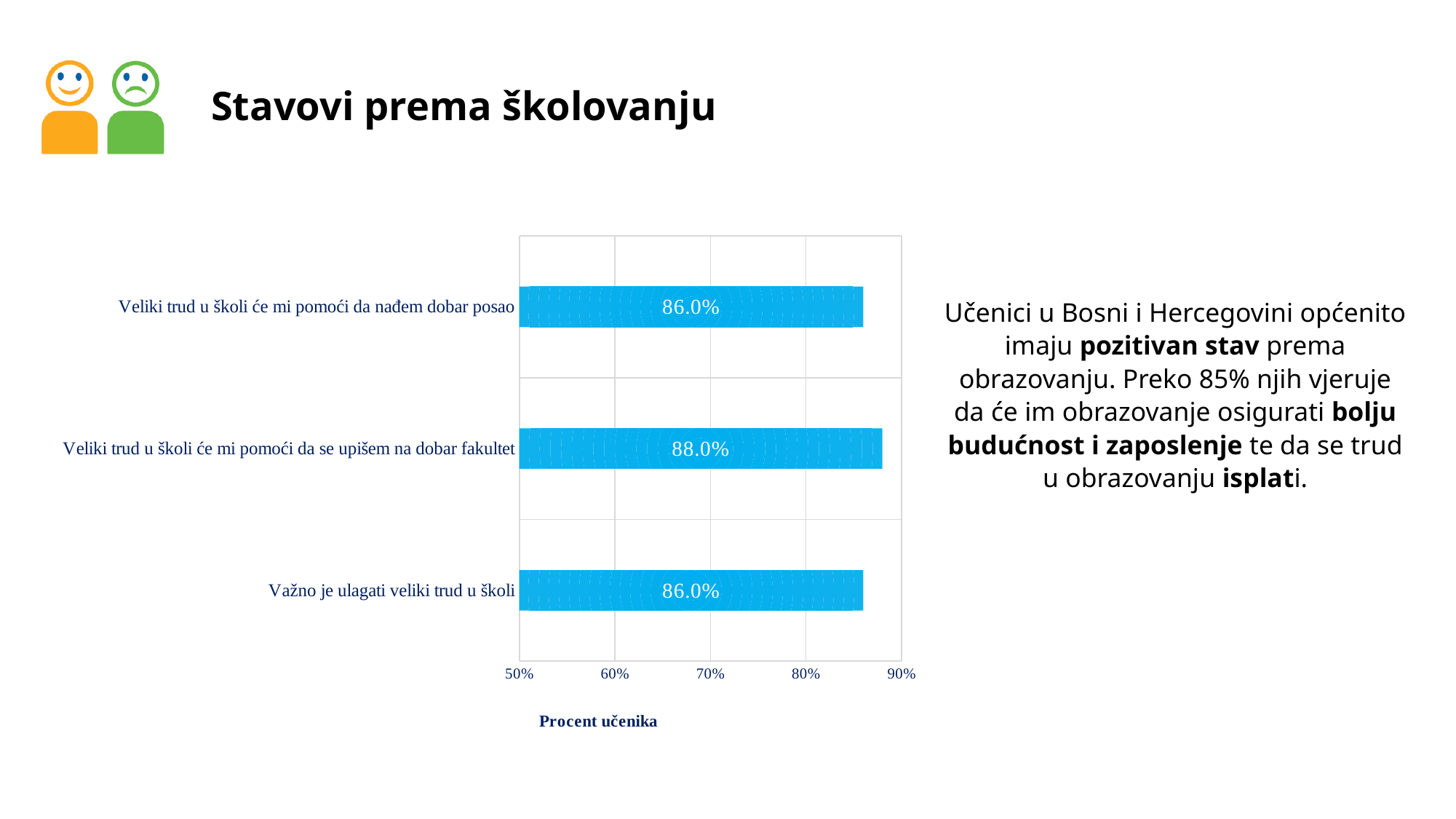
What is the label of the horizontal axis of the chart? Procent učenika What is the value for "Veliki trud u školi će mi pomoći da se upišem na dobar fakultet"? 88.0% What kind of chart is shown on the slide? Bar chart What is the value for "Važno je ulagati veliki trud u školi"? 86.0% Which is larger: the value for "Veliki trud u školi će mi pomoći da se upišem na dobar fakultet" or the value for "Veliki trud u školi će mi pomoći da nađem dobar posao"? Veliki trud u školi će mi pomoći da se upišem na dobar fakultet What is the value for "Veliki trud u školi će mi pomoći da nađem dobar posao"? 86.0% Is the value for "Važno je ulagati veliki trud u školi" greater or less than 80%? greater What is the title of the slide containing the chart? Stavovi prema školovanju Is the value for "Veliki trud u školi će mi pomoći da se upišem na dobar fakultet" greater or less than 90%? less What is the difference between the value for "Veliki trud u školi će mi pomoći da se upišem na dobar fakultet" and the value for "Važno je ulagati veliki trud u školi"? 2.0% How many categories are shown in the chart? 3 Which category has the highest value? Veliki trud u školi će mi pomoći da se upišem na dobar fakultet